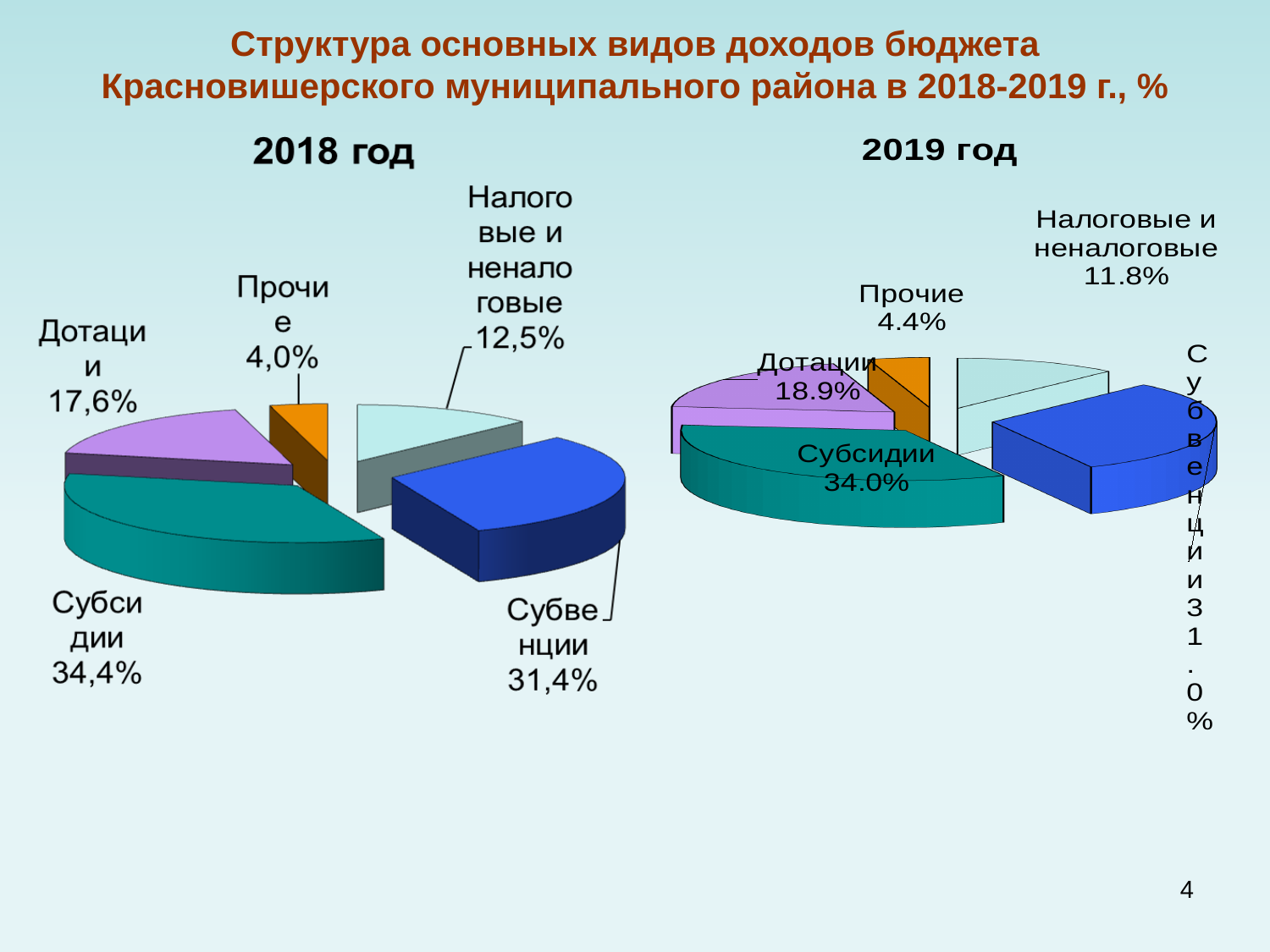
In the 2019 год chart, what share is shown for Налоговые и неналоговые? 11.8% In the 2018 год chart, which category has the largest share? Субсидии In the 2018 год chart, what share is shown for Субвенции? 31,4% In the 2019 год chart, which is larger: Субсидии or Субвенции? Субсидии In the 2019 год chart, what share is shown for Прочие? 4.4% In the 2019 год chart, what is the difference between the shares of Дотации and Налоговые и неналоговые? 7.1% In the 2018 год chart, what share is shown for Дотации? 17,6% What type of chart is the 2019 год chart? Pie chart How many charts are shown on the slide? 2 How many slices does the 2018 год chart have? 5 In the 2019 год chart, which category has the smallest share? Прочие In the 2018 год chart, what is the difference between the shares of Субсидии and Субвенции? 3,0%